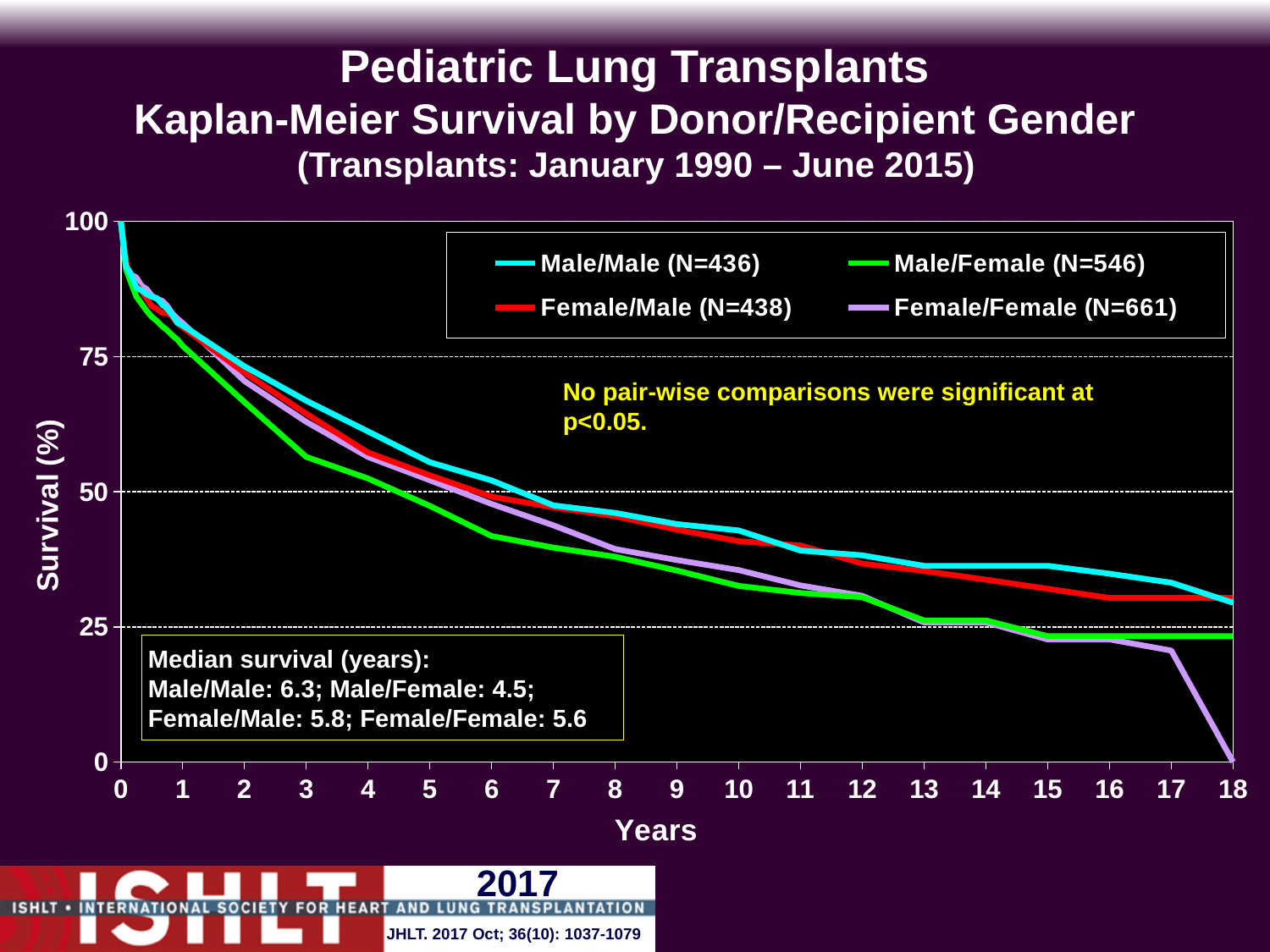
Do the survival curves rise or fall as years increase? fall At 3 years, which group has higher survival: Male/Male or Male/Female? Male/Male What is the median survival in years for the Male/Female group? 4.5 What is the difference in median survival (years) between the Male/Male and Male/Female groups? 1.8 What is the median survival in years for the Female/Male group? 5.8 What is the N for the Female/Female group shown in the legend? 661 Which donor/recipient gender group has the lowest median survival? Male/Female Is the survival value for the Male/Female group at 3 years greater or less than 50? greater What kind of chart is shown on the slide? line chart How many series does the legend list? 4 Which donor/recipient gender group has the highest median survival? Male/Male What is the N for the Male/Male group shown in the legend? 436